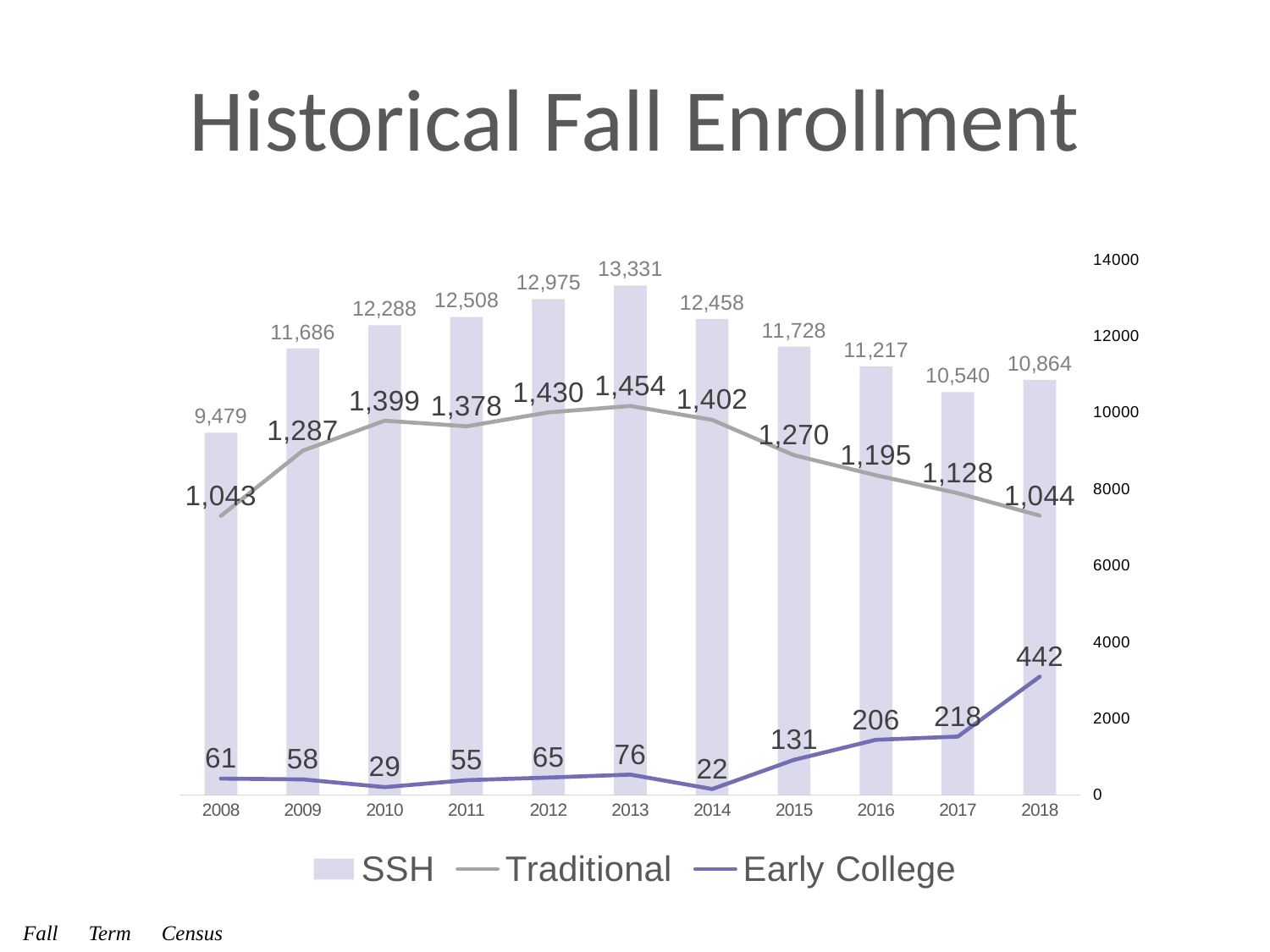
What is the SSH value for 2013? 13,331 How many years are shown on the x axis? 11 Do the Early College values rise or fall from 2015 to 2018? rise Which year has the lowest Early College value? 2014 Which year has the highest SSH value? 2013 What is the difference between the SSH values for 2013 and 2008? 3,852 Which is larger, the Traditional value for 2009 or for 2017? 2009 How many series does the legend list? 3 What is the Traditional value for 2010? 1,399 What is the Early College value for 2018? 442 What is the title of the chart? Historical Fall Enrollment Which series is drawn as bars? SSH